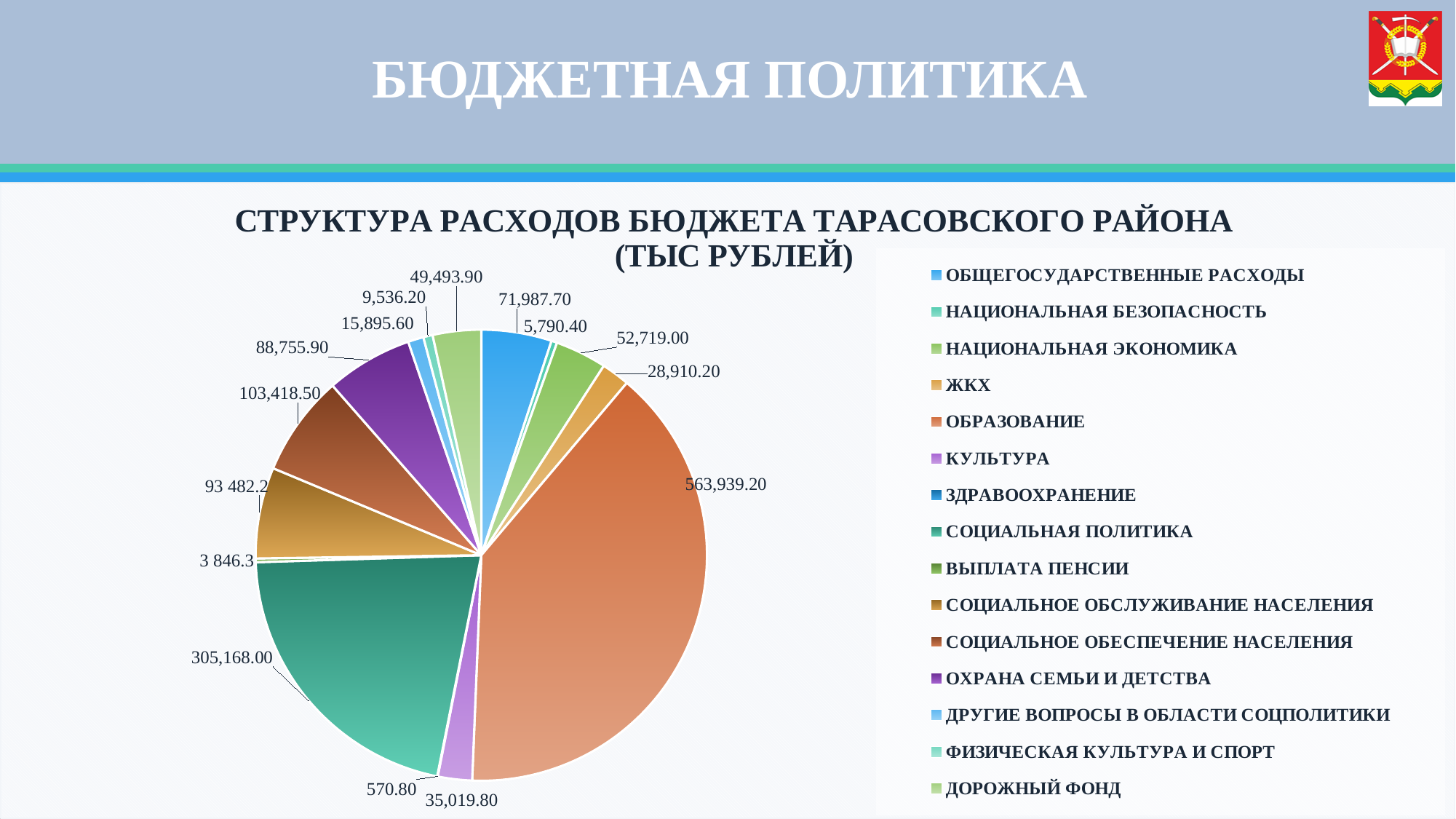
What is the difference between the values for ОБРАЗОВАНИЕ and СОЦИАЛЬНАЯ ПОЛИТИКА? 258,771.20 What is the value for СОЦИАЛЬНАЯ ПОЛИТИКА in the pie chart? 305,168.00 Which category has the largest slice in the pie chart? ОБРАЗОВАНИЕ What is the value for ОБЩЕГОСУДАРСТВЕННЫЕ РАСХОДЫ in the pie chart? 71,987.70 What is the value for ДОРОЖНЫЙ ФОНД in the pie chart? 49,493.90 What type of chart is shown on the slide? pie chart What is the value for ОХРАНА СЕМЬИ И ДЕТСТВА in the pie chart? 88,755.90 Which is larger, the value for СОЦИАЛЬНОЕ ОБЕСПЕЧЕНИЕ НАСЕЛЕНИЯ or the value for ОХРАНА СЕМЬИ И ДЕТСТВА? СОЦИАЛЬНОЕ ОБЕСПЕЧЕНИЕ НАСЕЛЕНИЯ Which category has the smallest slice in the pie chart? ЗДРАВООХРАНЕНИЕ How many categories does the legend of the pie chart list? 15 What is the value for СОЦИАЛЬНОЕ ОБЕСПЕЧЕНИЕ НАСЕЛЕНИЯ in the pie chart? 103,418.50 What is the value for ОБРАЗОВАНИЕ in the pie chart? 563,939.20